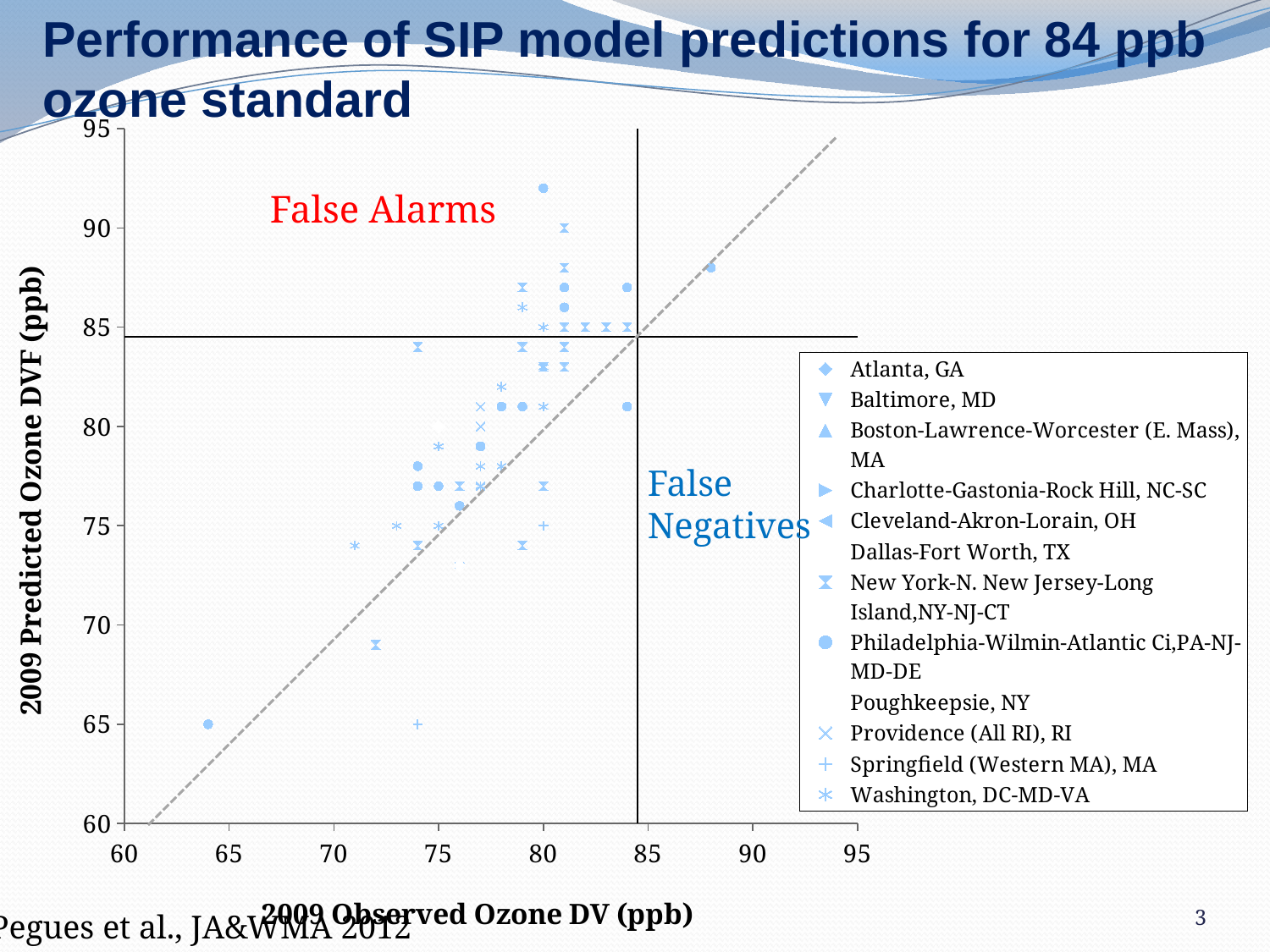
Is the lowest predicted ozone value plotted on the chart greater or less than 70? less Is the highest predicted ozone value plotted on the chart greater or less than 90? greater What is the title of the chart's y axis? 2009 Predicted Ozone DVF (ppb) Is the lowest observed ozone value plotted on the chart greater or less than 65? less How many series does the legend list? 12 What is the maximum value shown on the y axis? 95 What is the minimum value shown on the x axis? 60 What kind of chart is shown on the slide? scatter chart